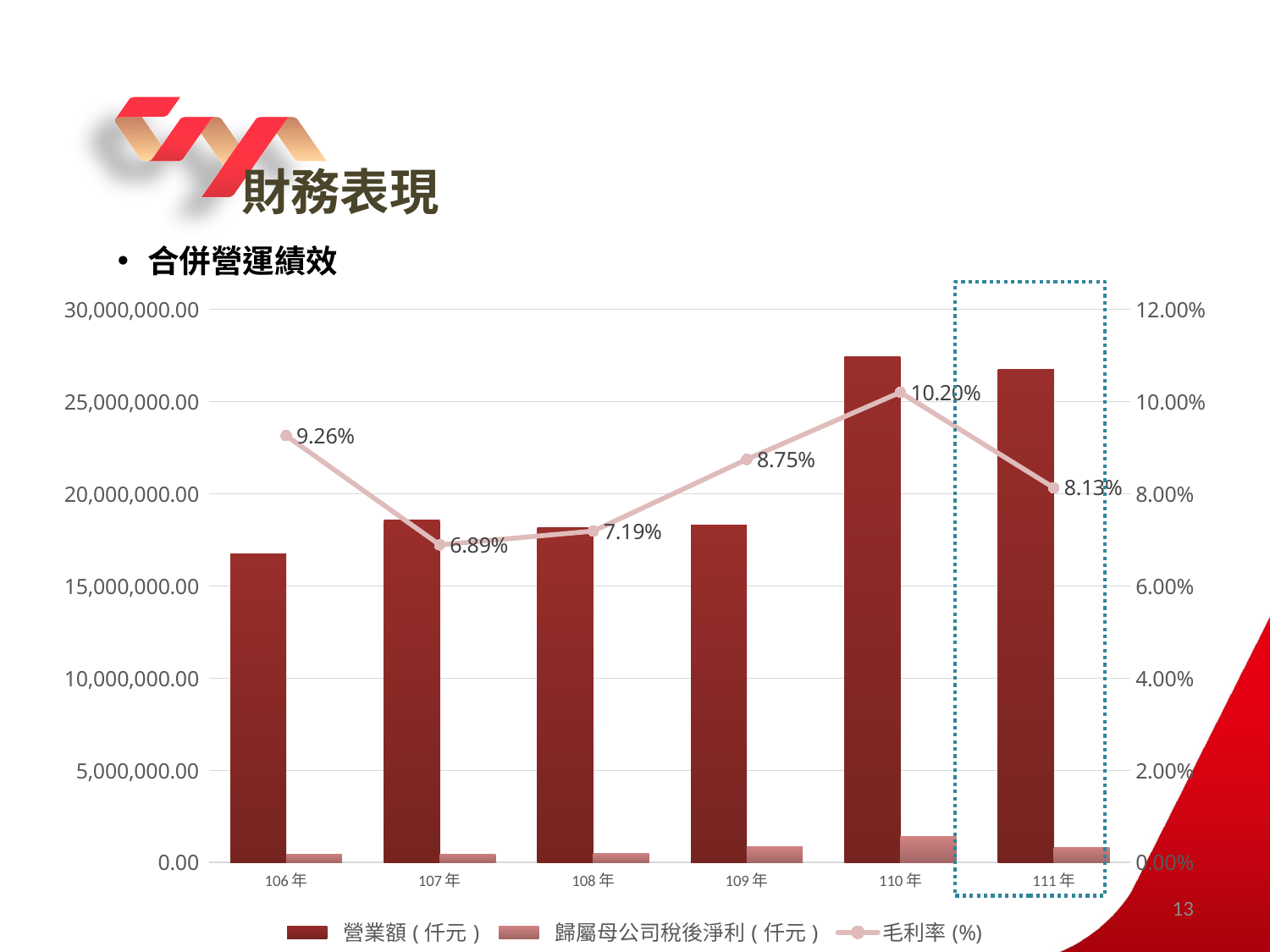
How many years are shown on the x axis of the chart? 6 How many series does the chart legend list? 3 Is the 營業額 ( 仟元 ) value for 110 年 greater or less than 25,000,000.00? greater What is the 毛利率 (%) value for 107 年? 6.89% Which is larger, the 毛利率 (%) for 108 年 or for 109 年? 109 年 Is the 營業額 ( 仟元 ) value for 106 年 greater or less than 20,000,000.00? less Which year has the lowest 毛利率 (%)? 107 年 What is the difference between the 毛利率 (%) for 110 年 and 107 年? 3.31% Which year has the highest 毛利率 (%)? 110 年 Which year has the lowest 營業額 ( 仟元 ) bar? 106 年 What is the 毛利率 (%) value for 110 年? 10.20% What is the 毛利率 (%) value for 106 年? 9.26%